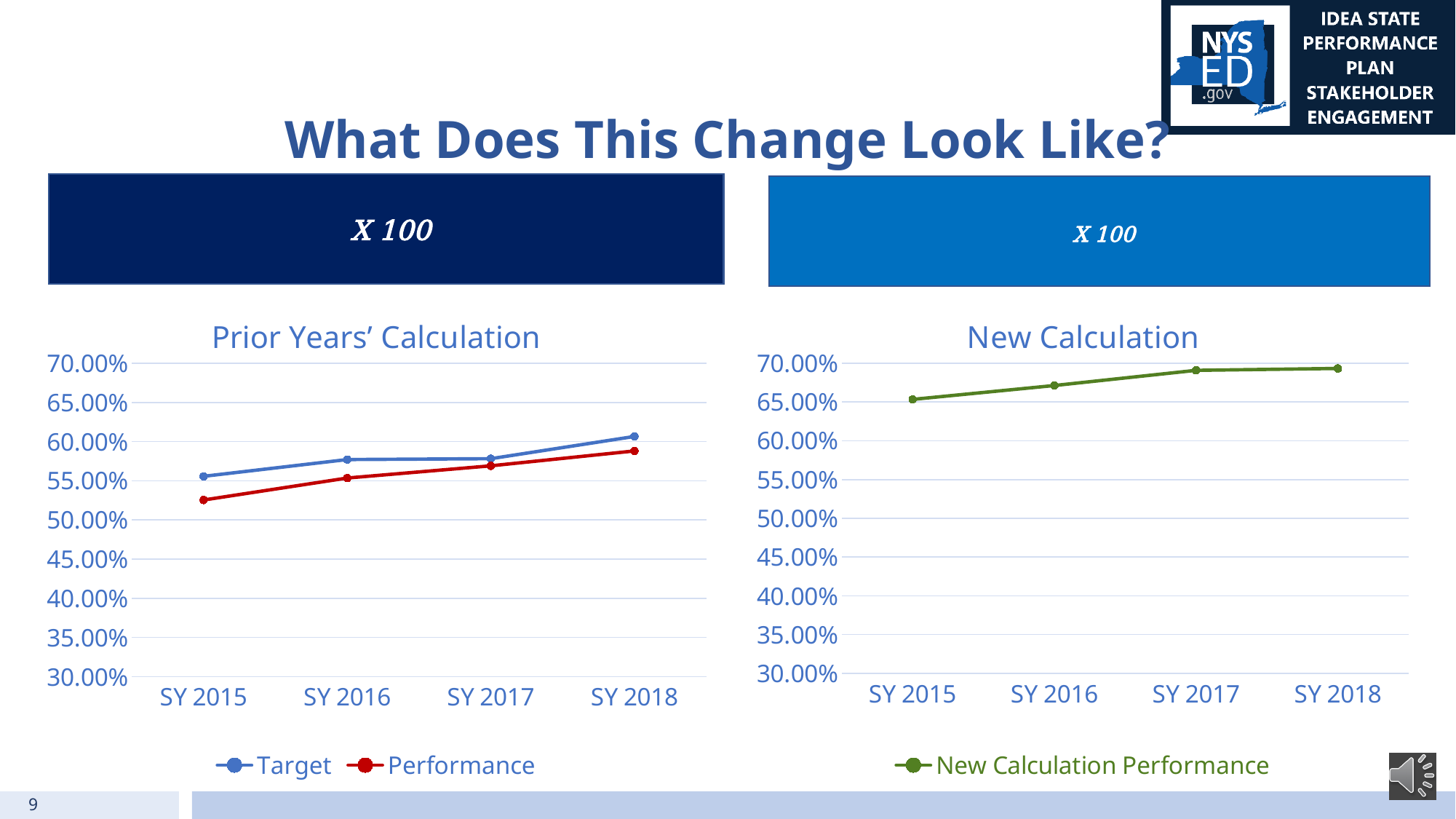
How many school years are shown on the x axis of the "New Calculation" chart? 4 In the "Prior Years' Calculation" chart, is the Performance value for SY 2015 greater or less than 55.00%? less In the "New Calculation" chart, which school year has the lowest value? SY 2015 How many series does the legend of the "Prior Years' Calculation" chart list? 2 In the "Prior Years' Calculation" chart, which is larger for SY 2015, Target or Performance? Target What kind of chart is the "Prior Years' Calculation" chart? line chart In the "New Calculation" chart, is the value for SY 2018 greater or less than 70.00%? less In the "New Calculation" chart, do the values rise or fall from SY 2015 to SY 2018? rise In the "New Calculation" chart, is the value for SY 2017 greater or less than 65.00%? greater How many series does the legend of the "New Calculation" chart list? 1 In the "Prior Years' Calculation" chart, do the Performance values rise or fall from SY 2015 to SY 2018? rise What is the legend entry of the "New Calculation" chart? New Calculation Performance